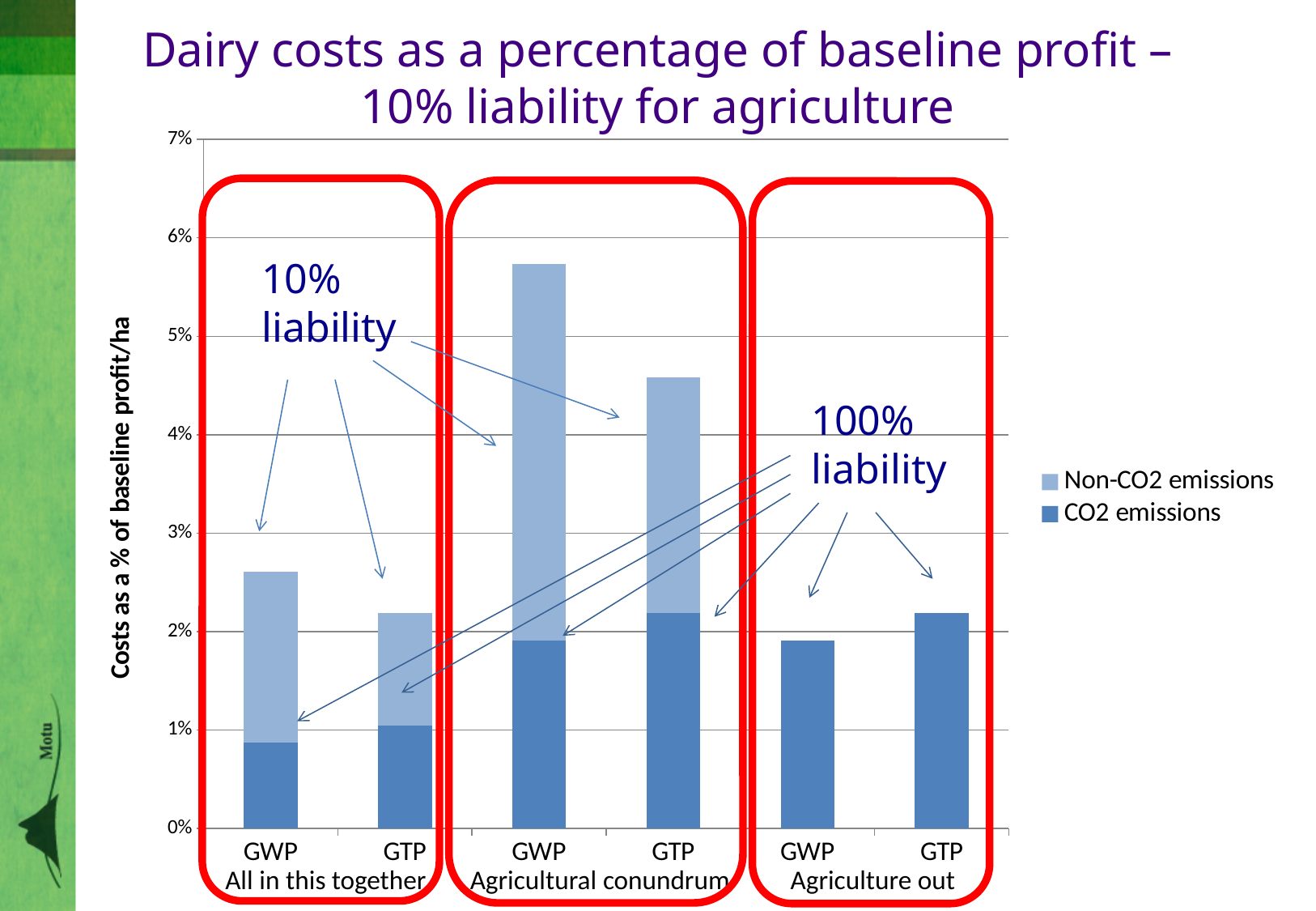
How many bars are plotted in the chart? 6 Which bar has the lowest total cost as a percentage of baseline profit? GWP, Agriculture out What kind of chart is shown on the slide? stacked bar chart What is the label of the vertical axis? Costs as a % of baseline profit/ha Which bar has the highest total cost as a percentage of baseline profit? GWP, Agricultural conundrum Is the CO2 emissions portion for GWP under All in this together greater or less than 1%? less Is the total for GWP under All in this together greater or less than 3%? less Which is larger: the total for GWP or GTP under Agricultural conundrum? GWP Is the total for GTP under Agricultural conundrum greater or less than 4%? greater How many series does the legend list? 2 Which is larger: the total for GWP or GTP under Agriculture out? GTP